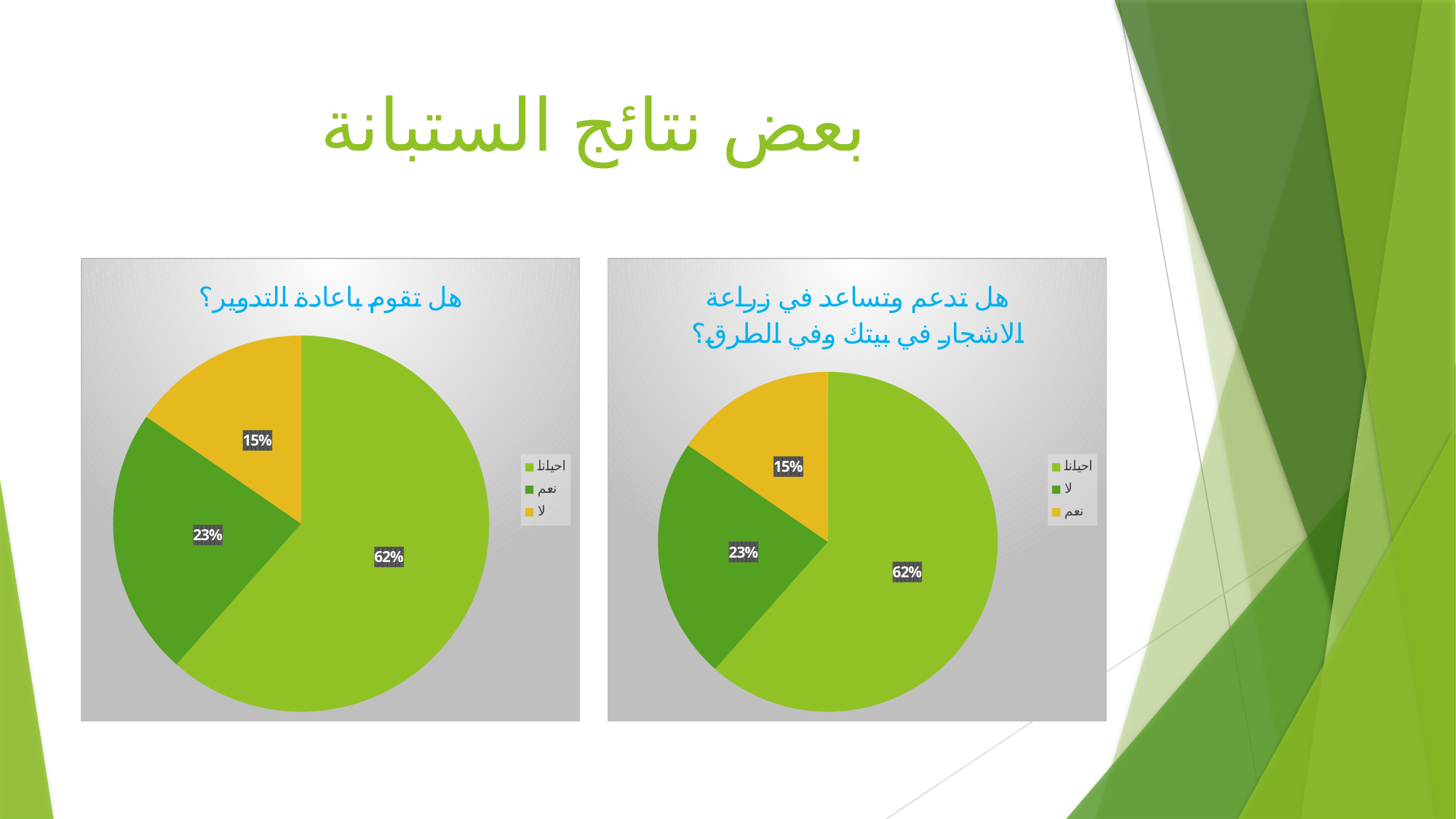
In the right pie chart (هل تدعم وتساعد في زراعة الاشجار في بيتك وفي الطرق؟), what percentage is shown for نعم? 15% In the right pie chart (هل تدعم وتساعد في زراعة الاشجار في بيتك وفي الطرق؟), what percentage is shown for لا? 23% In the left pie chart, what is the difference in percentage points between احيانا and نعم? 39 How many slices does the left pie chart have? 3 In the left pie chart (هل تقوم باعادة التدوير؟), what percentage is shown for احيانا? 62% In the right pie chart, which category has the largest share? احيانا In the left pie chart (هل تقوم باعادة التدوير؟), what percentage is shown for لا? 15% What type of chart is the right chart on the slide? Pie chart In the right pie chart, which is larger: the share for لا or the share for نعم? لا In the left pie chart (هل تقوم باعادة التدوير؟), what percentage is shown for نعم? 23% In the right pie chart, which colour represents نعم in the legend? Yellow In the left pie chart, which category has the smallest share? لا